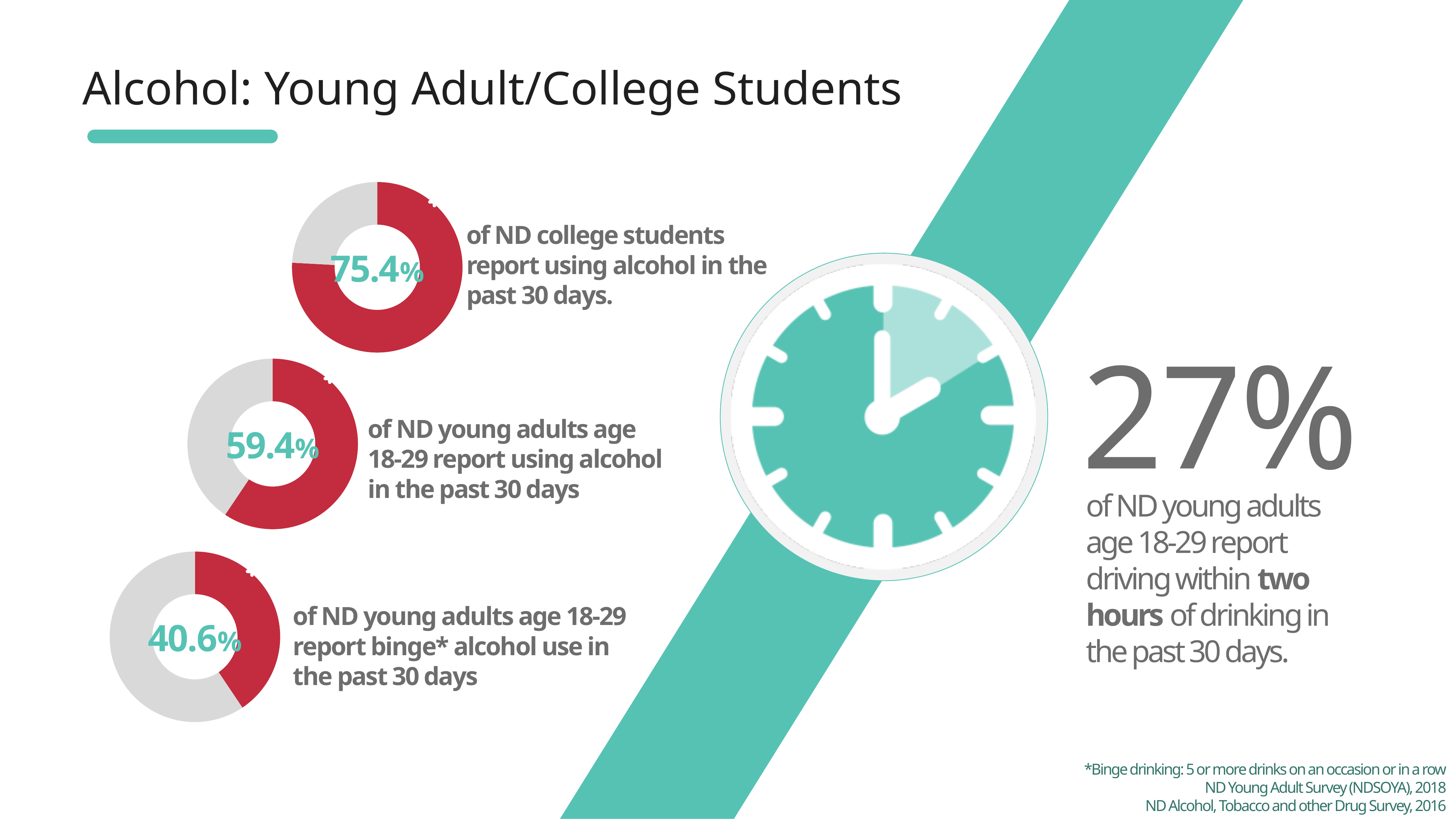
In the bottom donut chart, what percentage of ND young adults age 18-29 report binge alcohol use in the past 30 days? 40.6% What is the difference between the percentage of ND college students using alcohol (top chart) and the percentage of ND young adults age 18-29 using alcohol (middle chart)? 16.0 percentage points What is the difference between the percentage of ND young adults age 18-29 using alcohol (middle chart) and the percentage reporting binge alcohol use (bottom chart)? 18.8 percentage points In the top donut chart, what percentage of ND college students report using alcohol in the past 30 days? 75.4% Which is larger: the percentage of ND college students using alcohol in the past 30 days or the percentage of ND young adults age 18-29 using alcohol in the past 30 days? ND college students (75.4%) In the middle donut chart, what percentage of ND young adults age 18-29 report using alcohol in the past 30 days? 59.4% Which of the three donut charts shows the highest percentage? The top chart (ND college students using alcohol, 75.4%) Which of the three donut charts shows the lowest percentage? The bottom chart (binge alcohol use, 40.6%) What kind of charts are used on the left side of the slide to show the alcohol-use percentages? Donut (pie) charts What colour is used for the filled (highlighted) portion of each donut chart? Red How many donut charts are shown on the slide? 3 In the bottom donut chart, what share of the ring is filled in red? 40.6%